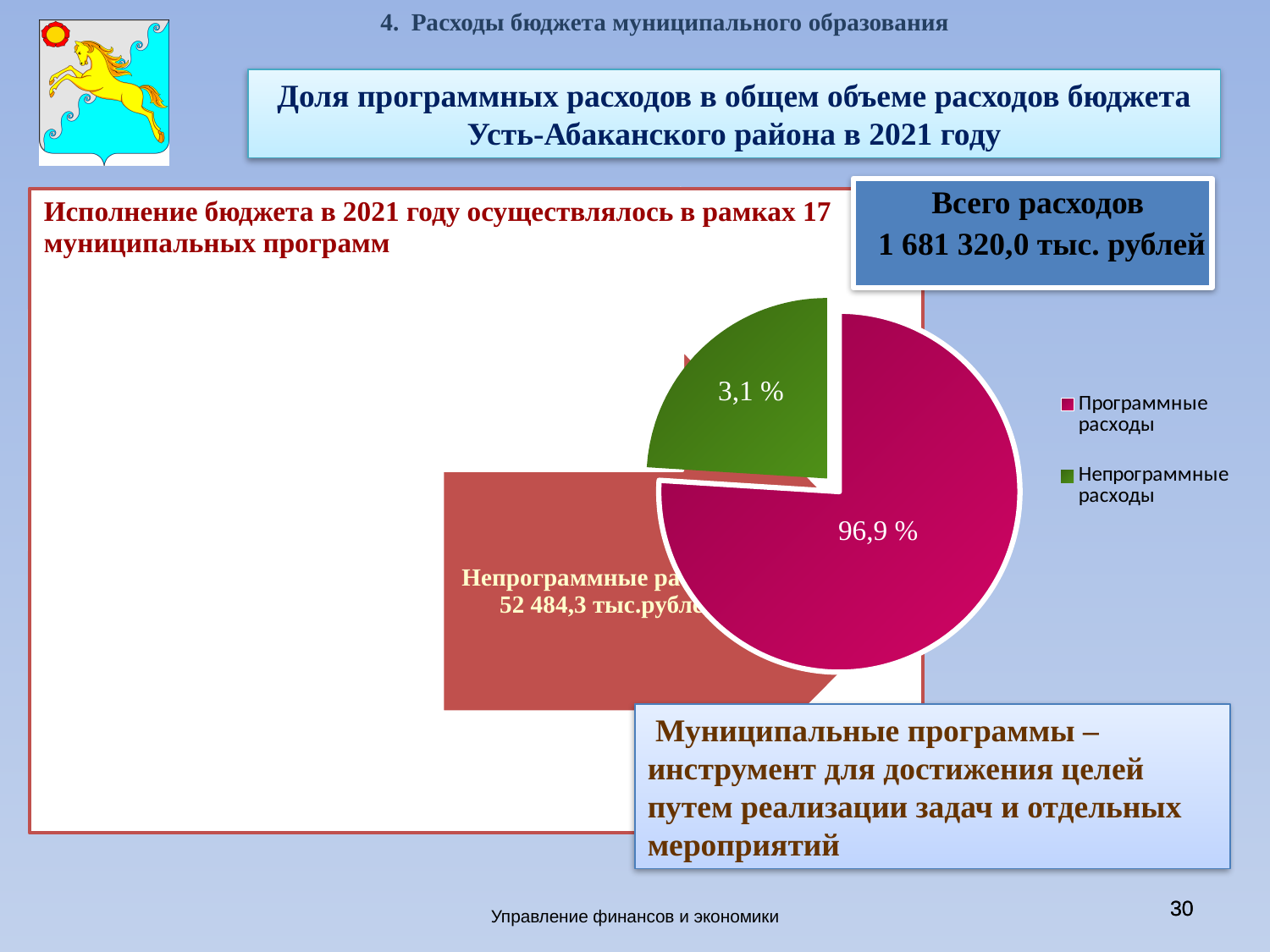
Is the share of "Программные расходы" greater or less than 90 %? greater Which slice of the pie chart is the largest? Программные расходы What kind of chart is shown on the slide? pie chart How many entries does the legend of the pie chart list? 2 Which slice of the pie chart is the smallest? Непрограммные расходы What is the difference in percentage points between the "Программные расходы" and "Непрограммные расходы" slices? 93,8 What share of the pie does "Непрограммные расходы" have? 3,1 % Which is larger in the pie chart: "Программные расходы" or "Непрограммные расходы"? Программные расходы What colour is the "Программные расходы" slice in the pie chart? magenta (crimson) What colour is the "Непрограммные расходы" slice in the pie chart? green What share of the pie does "Программные расходы" have? 96,9 % How many slices does the pie chart have? 2